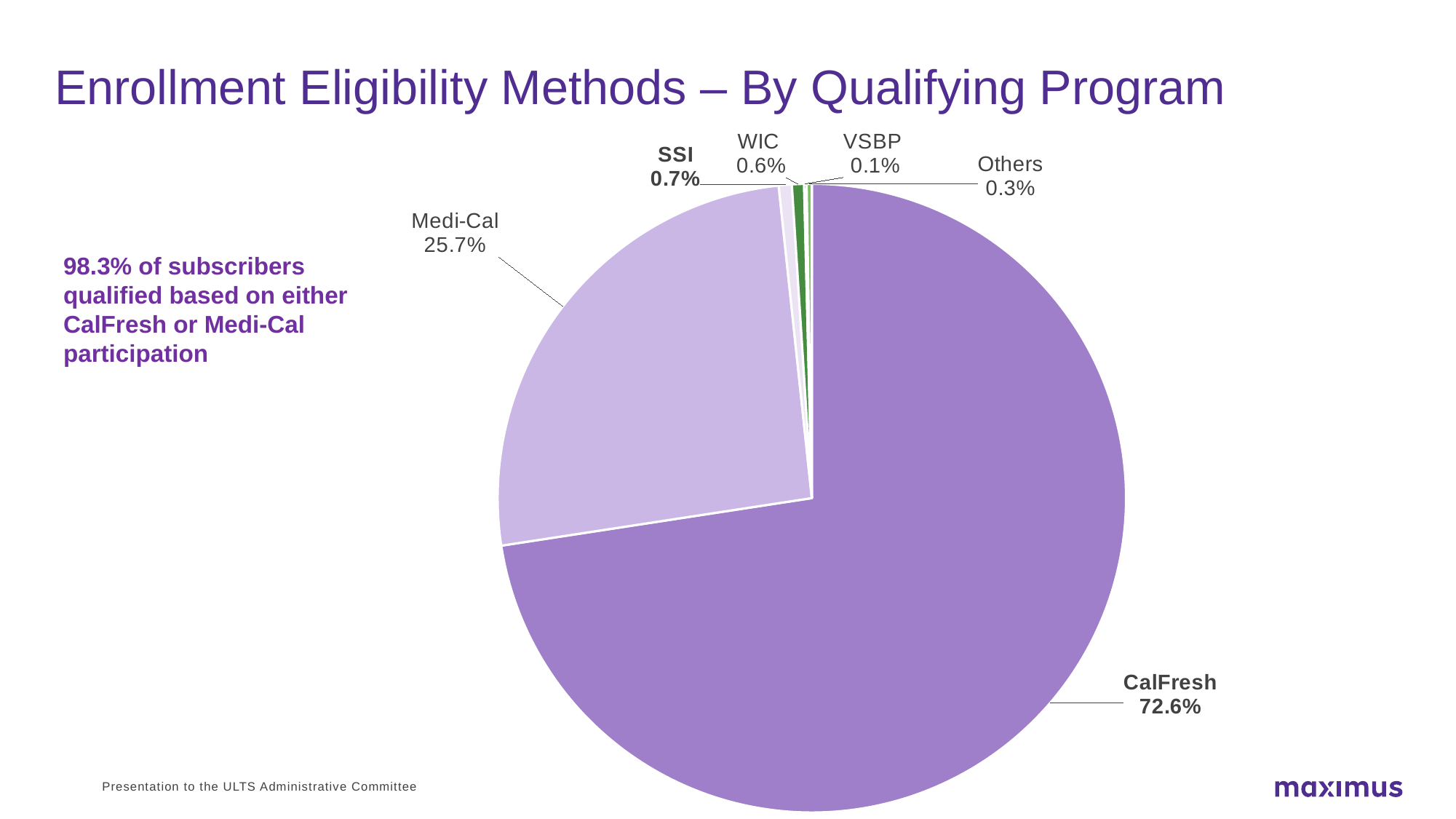
What is the value shown for VSBP? 0.1% Which qualifying program has the smallest slice of the pie? VSBP What type of chart is shown on the slide? pie chart What is the value shown for SSI? 0.7% What share of the pie does Medi-Cal represent? 25.7% What share of the pie does CalFresh represent? 72.6% Which qualifying program has the largest slice of the pie? CalFresh How many slices does the pie chart have? 6 What is the title of the slide containing the chart? Enrollment Eligibility Methods – By Qualifying Program What is the difference between the CalFresh and Medi-Cal shares? 46.9% What is the value shown for WIC? 0.6% What is the value shown for Others? 0.3%